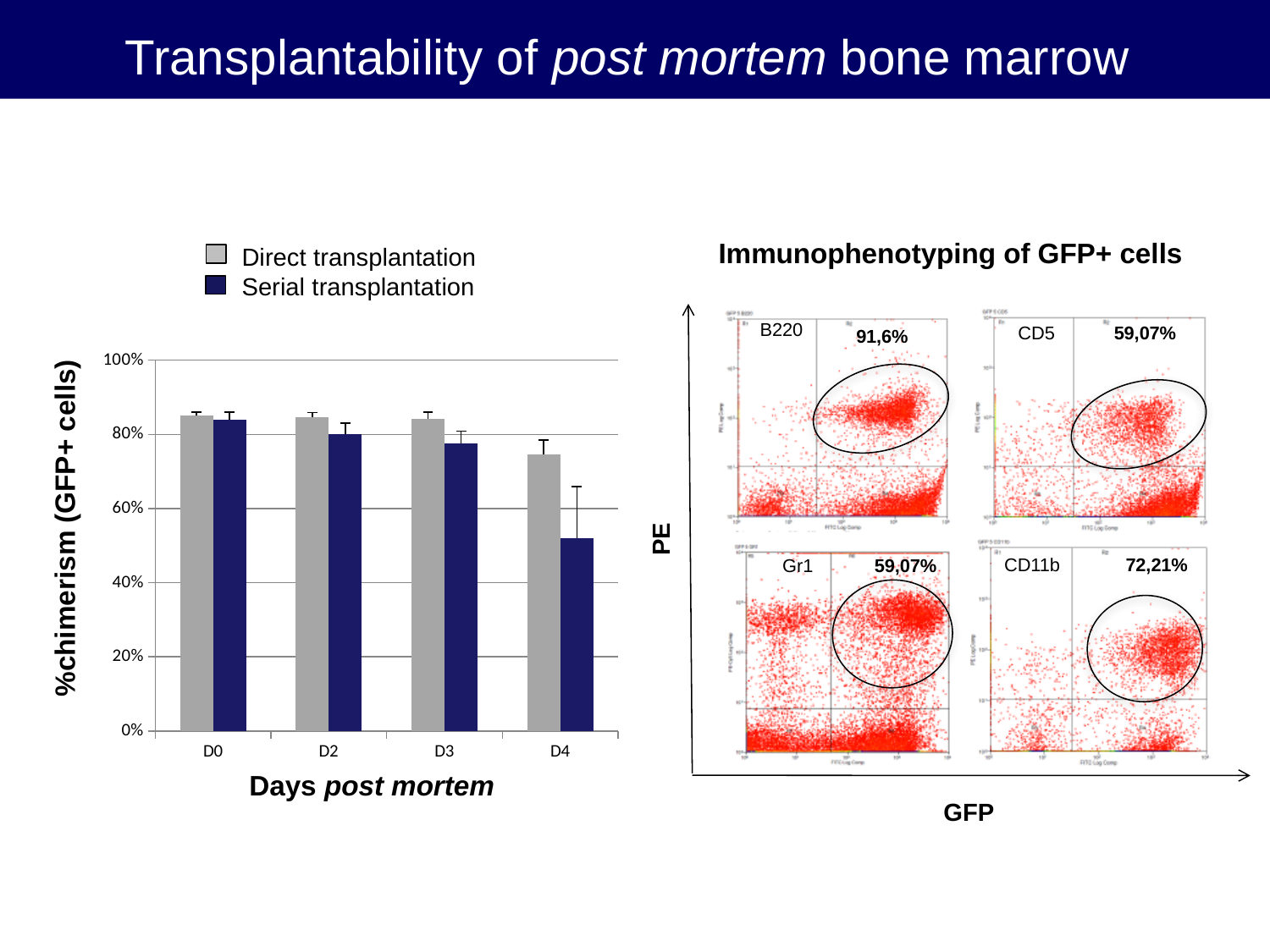
On the bar chart on the left, what kind of chart is it? bar chart On the bar chart on the left, does the Serial transplantation series rise or fall from D0 to D4? fall On the bar chart on the left, is the Direct transplantation value at D4 greater or less than 80%? less On the bar chart on the left, how many series does the legend list? 2 In the Immunophenotyping of GFP+ cells panel, what percentage is shown for CD11b? 72,21% On the bar chart on the left, at which day is the Serial transplantation value lowest? D4 On the bar chart on the left, is the Direct transplantation value at D0 greater or less than 80%? greater On the bar chart on the left, is the Serial transplantation value at D4 greater or less than 60%? less On the bar chart on the left, at D4, which is larger: Direct transplantation or Serial transplantation? Direct transplantation In the Immunophenotyping of GFP+ cells panel, which marker has the highest percentage? B220 On the bar chart on the left, how many day categories are shown on the x axis? 4 In the Immunophenotyping of GFP+ cells panel, what percentage is shown for B220? 91,6%